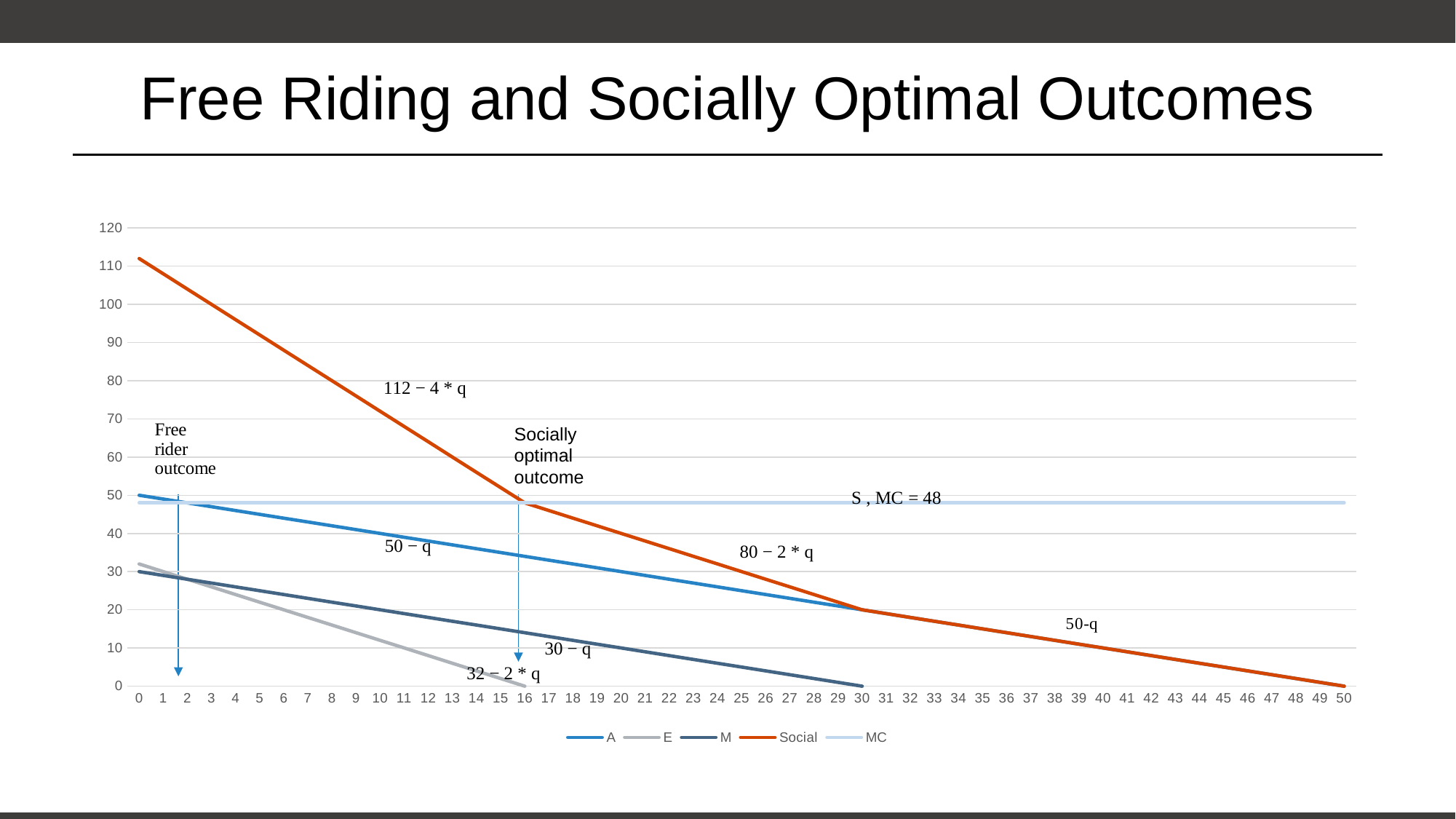
At q = 10, which is larger, the E line or the M line? M At q = 0, which is larger, the A line or the M line? A What is the value of the MC line, as labelled on the chart? 48 How many series does the legend list? 5 What formula is written next to the steepest segment of the Social line? 112 − 4 * q What kind of chart is shown on the slide? line chart Does the Social line rise or fall as q increases along the x axis? fall Which series has the highest value at q = 0? Social Is the value of the A line at q = 30 greater or less than 30? less What is the value of the A line at q = 0? 50 Is the value of the Social line at q = 10 greater or less than 70? greater What label is written at the point where the Social line meets the MC line? Socially optimal outcome